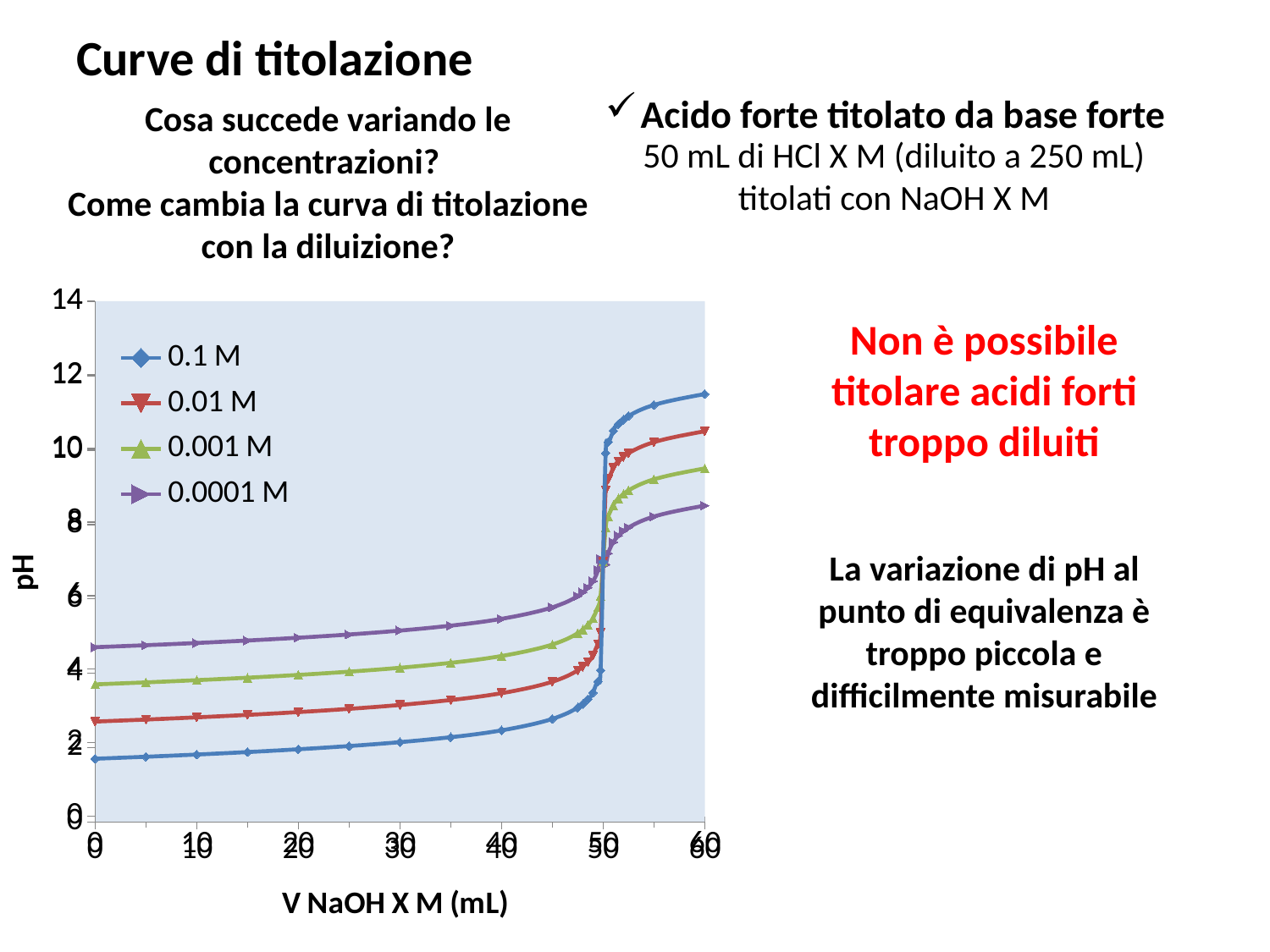
At 0 mL of NaOH, which series has the higher pH, 0.1 M or 0.0001 M? 0.0001 M Is the pH of the 0.0001 M series at 60 mL greater or less than 10? less How many series does the chart legend list? 4 Is the pH of the 0.0001 M series at 0 mL greater or less than 4? greater Does the pH of the 0.1 M series rise or fall as the volume of NaOH increases along the x axis? rise What is the title of the x axis of the chart? V NaOH X M (mL) What kind of chart is shown on the slide? line chart Is the pH of the 0.1 M series at 0 mL greater or less than 2? less At 60 mL of NaOH, which series has the lowest pH? 0.0001 M At 60 mL of NaOH, which series has the highest pH? 0.1 M What are the series names listed in the chart legend? 0.1 M, 0.01 M, 0.001 M, 0.0001 M